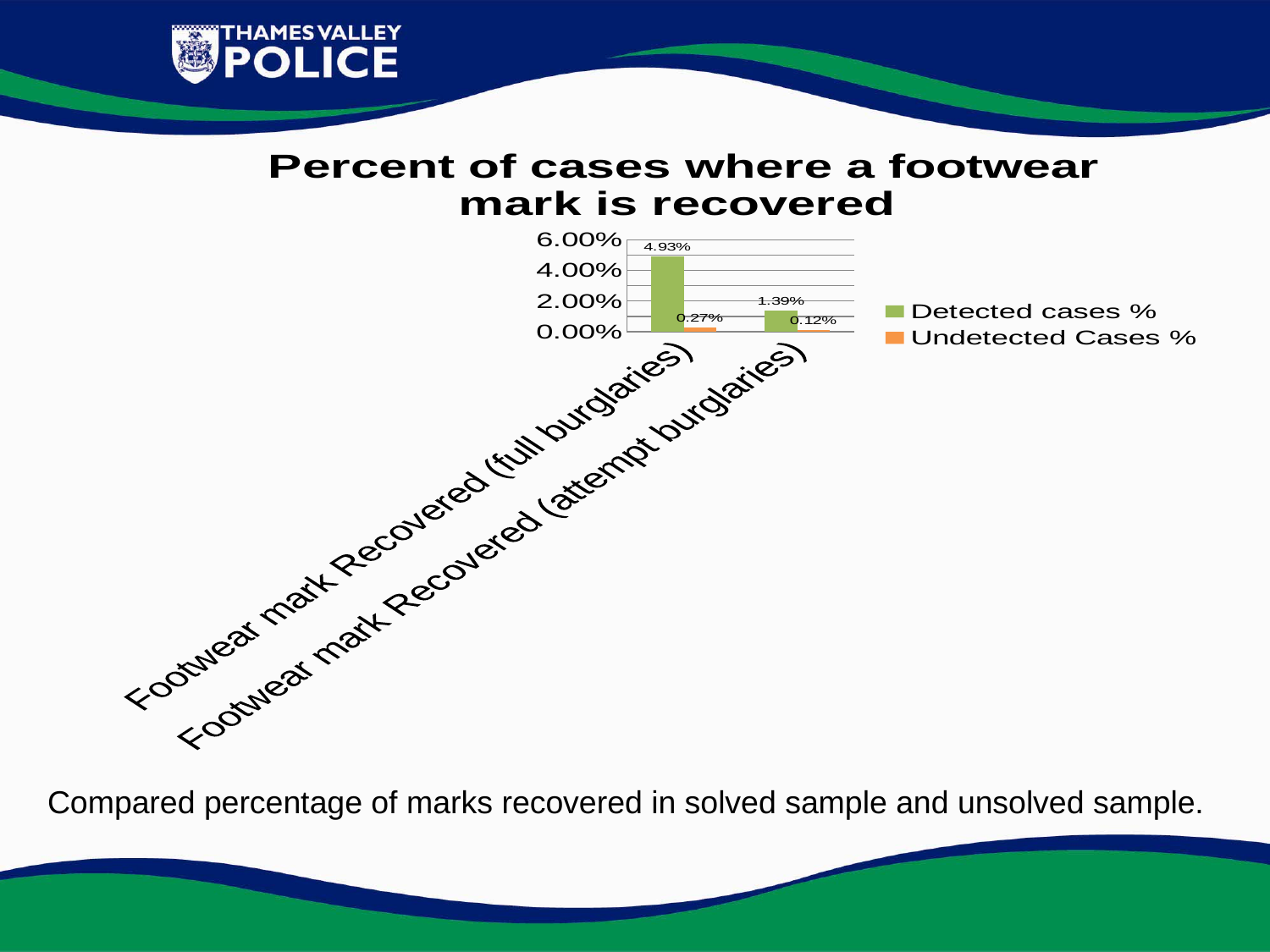
What is the Undetected Cases % value for Footwear mark Recovered (attempt burglaries)? 0.12% For Footwear mark Recovered (attempt burglaries), which is larger: Detected cases % or Undetected Cases %? Detected cases % What kind of chart is shown on the slide? Bar chart What is the difference between Detected cases % and Undetected Cases % for Footwear mark Recovered (full burglaries)? 4.66% What is the difference between the Detected cases % values for full burglaries and attempt burglaries? 3.54% What is the Detected cases % value for Footwear mark Recovered (attempt burglaries)? 1.39% Is the Detected cases % value for Footwear mark Recovered (full burglaries) greater or less than 4.00%? greater How many series does the legend list? 2 Which category has the lowest Undetected Cases % value? Footwear mark Recovered (attempt burglaries) What is the Detected cases % value for Footwear mark Recovered (full burglaries)? 4.93% What is the Undetected Cases % value for Footwear mark Recovered (full burglaries)? 0.27% Which category has the highest Detected cases % value? Footwear mark Recovered (full burglaries)